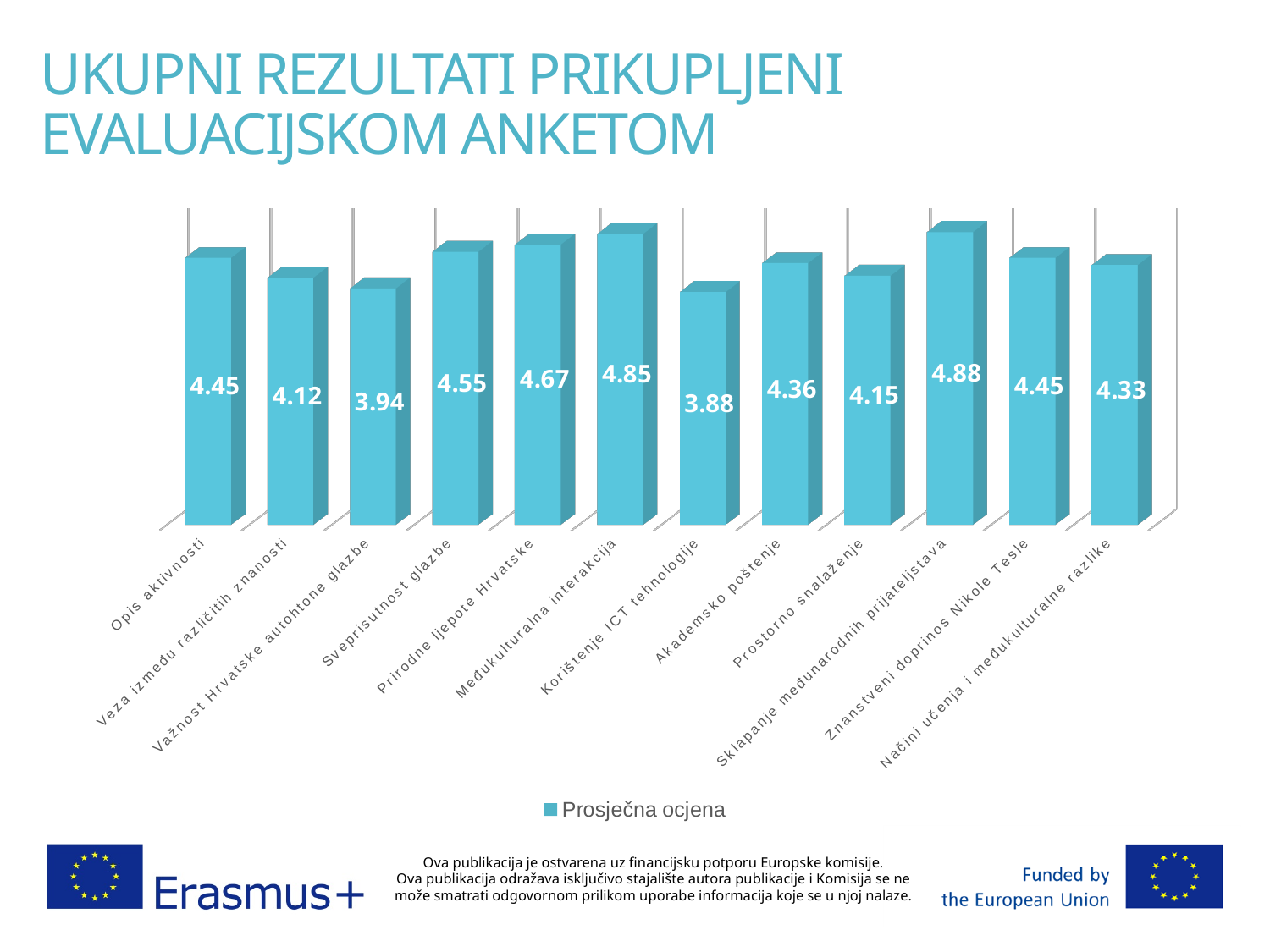
Which is larger, the value for Sveprisutnost glazbe or the value for Akademsko poštenje? Sveprisutnost glazbe What is the difference between the values for Međukulturalna interakcija and Važnost Hrvatske autohtone glazbe? 0.91 Which category has the highest value? Sklapanje međunarodnih prijateljstava What is the value for Prostorno snalaženje? 4.15 What is the value for Opis aktivnosti? 4.45 How many categories are shown in the chart? 12 What kind of chart is shown on the slide? Bar chart What is the legend entry of the chart? Prosječna ocjena What is the value for Sklapanje međunarodnih prijateljstava? 4.88 How many series does the legend list? 1 What is the value for Korištenje ICT tehnologije? 3.88 Which category has the lowest value? Korištenje ICT tehnologije